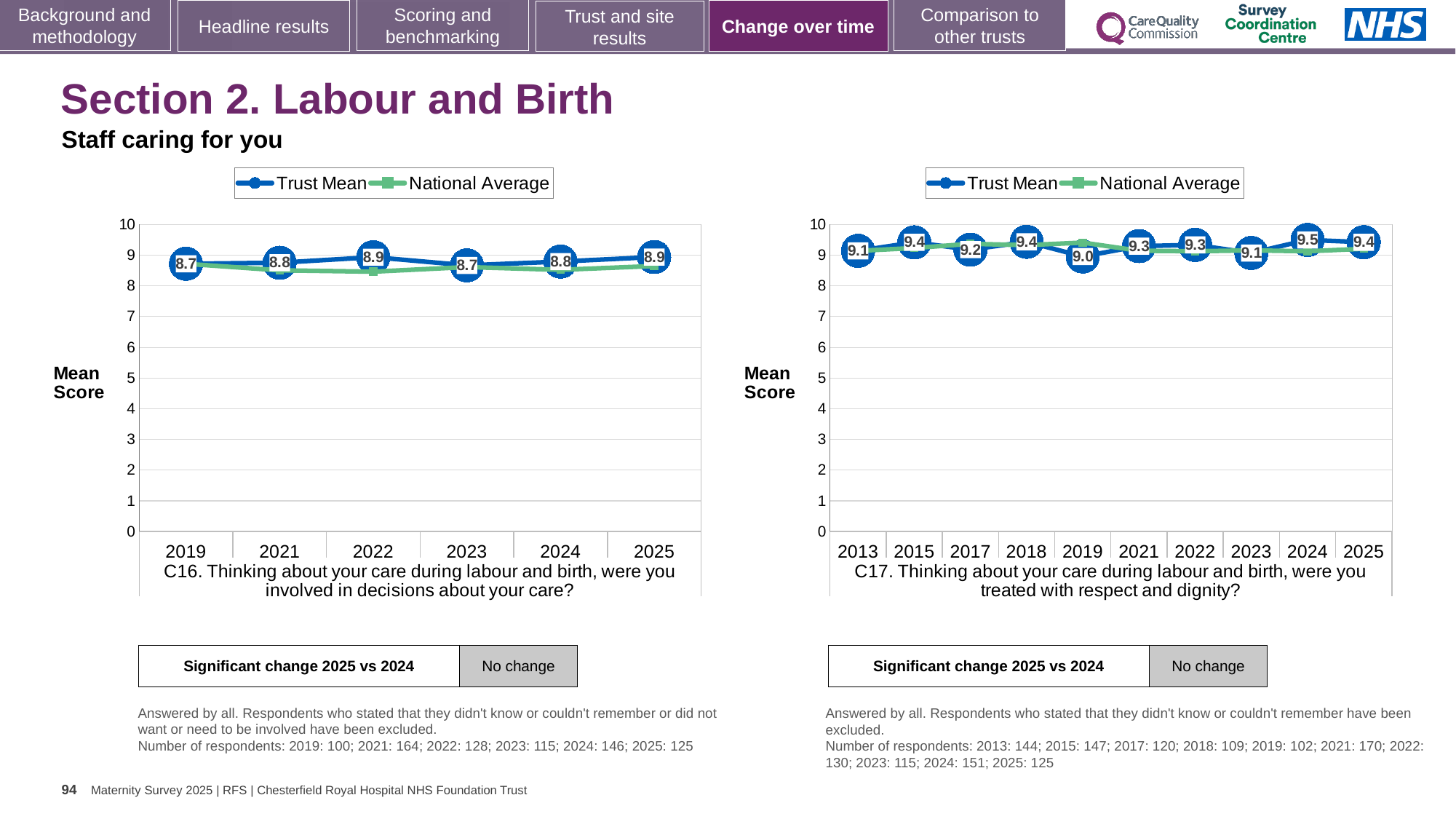
On the left chart (C16), is the National Average value for 2025 greater or less than 8? greater On the left chart (C16), is the Trust Mean score for 2022 larger or smaller than the score for 2023? larger How many series does the legend of the left chart (C16) list? 2 On the left chart (C16), what is the Trust Mean score for 2025? 8.9 On the right chart (C17), which year has the highest Trust Mean score? 2024 On the left chart (C16), what is the Trust Mean score for 2019? 8.7 What type of chart is the right chart (C17)? Line chart On the right chart (C17), which year has the lowest Trust Mean score? 2019 How many years are plotted on the right chart (C17)? 10 How many years are plotted on the left chart (C16)? 6 On the right chart (C17), what is the Trust Mean score for 2019? 9.0 On the right chart (C17), what is the difference between the Trust Mean scores for 2024 and 2019? 0.5